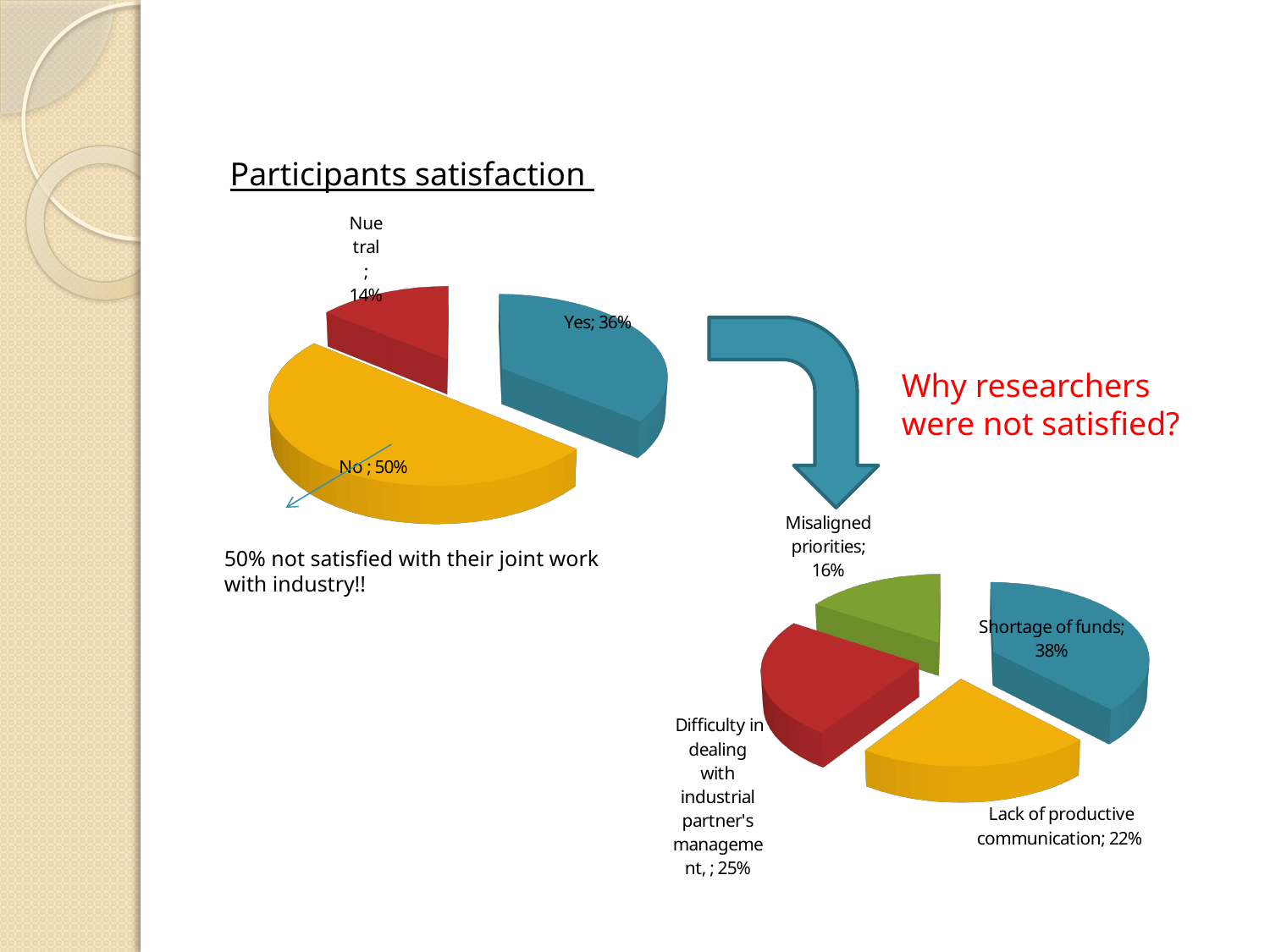
In the Participants satisfaction pie chart, what share of participants answered No? 50% What type of chart is used for 'Why researchers were not satisfied?'? Pie chart In the 'Why researchers were not satisfied?' pie chart, what share is attributed to Lack of productive communication? 22% In the 'Why researchers were not satisfied?' pie chart, which is larger: Difficulty in dealing with industrial partner's management or Lack of productive communication? Difficulty in dealing with industrial partner's management In the Participants satisfaction pie chart, how many slices are there? 3 In the 'Why researchers were not satisfied?' pie chart, which reason has the smallest share? Misaligned priorities In the Participants satisfaction pie chart, what share of participants were Neutral? 14% In the Participants satisfaction pie chart, which response has the smallest slice? Neutral In the Participants satisfaction pie chart, which response has the largest slice? No In the Participants satisfaction pie chart, how many percentage points larger is the No slice than the Yes slice? 14 In the 'Why researchers were not satisfied?' pie chart, what share is attributed to Shortage of funds? 38% In the Participants satisfaction pie chart, what share of participants answered Yes? 36%